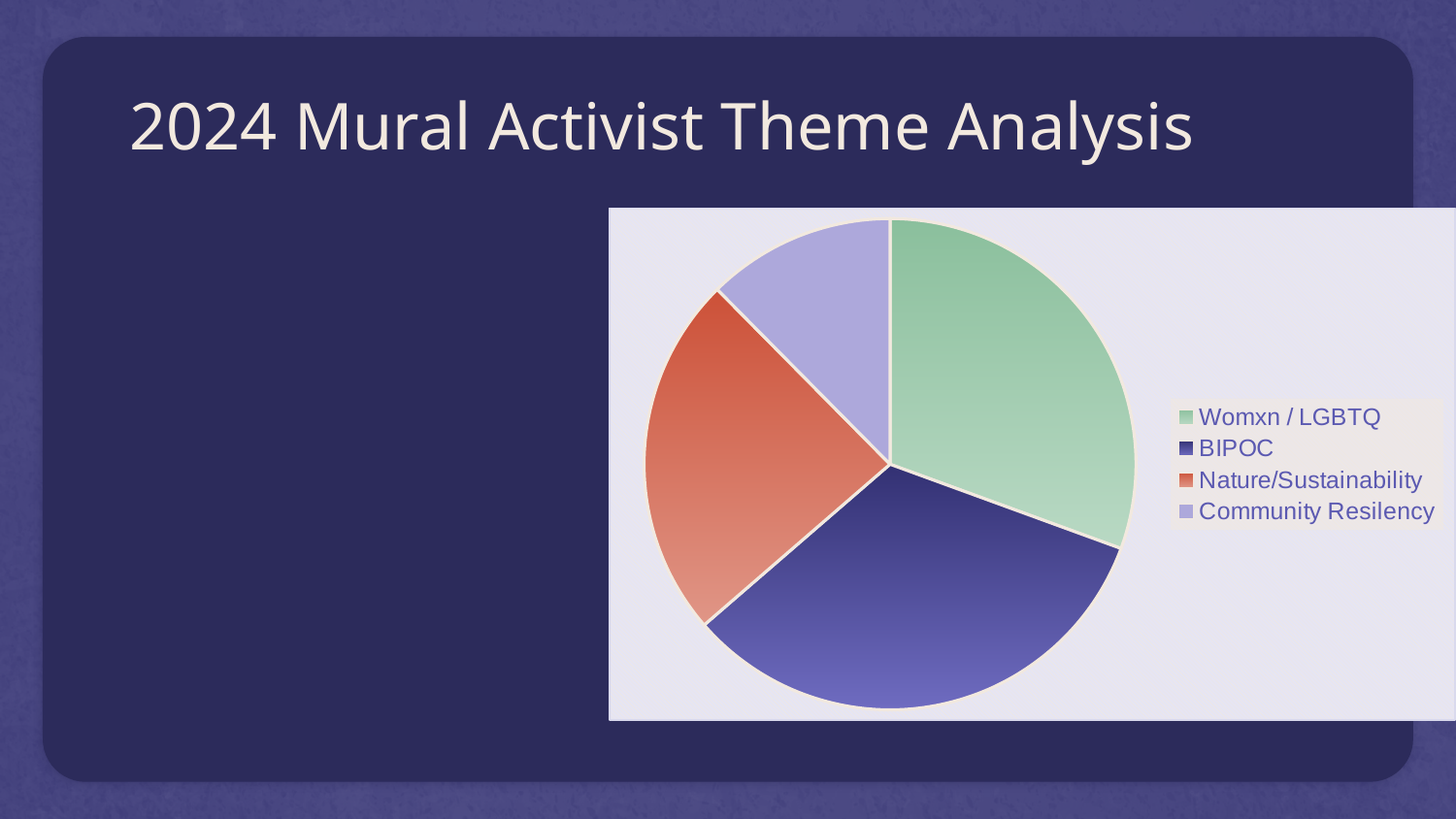
Which category is shown in green in the pie chart? Womxn / LGBTQ Which slice is larger, BIPOC or Nature/Sustainability? BIPOC Which slice is larger, Womxn / LGBTQ or Nature/Sustainability? Womxn / LGBTQ Which category has the smallest slice of the pie? Community Resilency Which slice is larger, BIPOC or Community Resiliency? BIPOC What is the title of the slide containing the pie chart? 2024 Mural Activist Theme Analysis What kind of chart is shown on the slide? pie chart How many categories does the pie chart show? 4